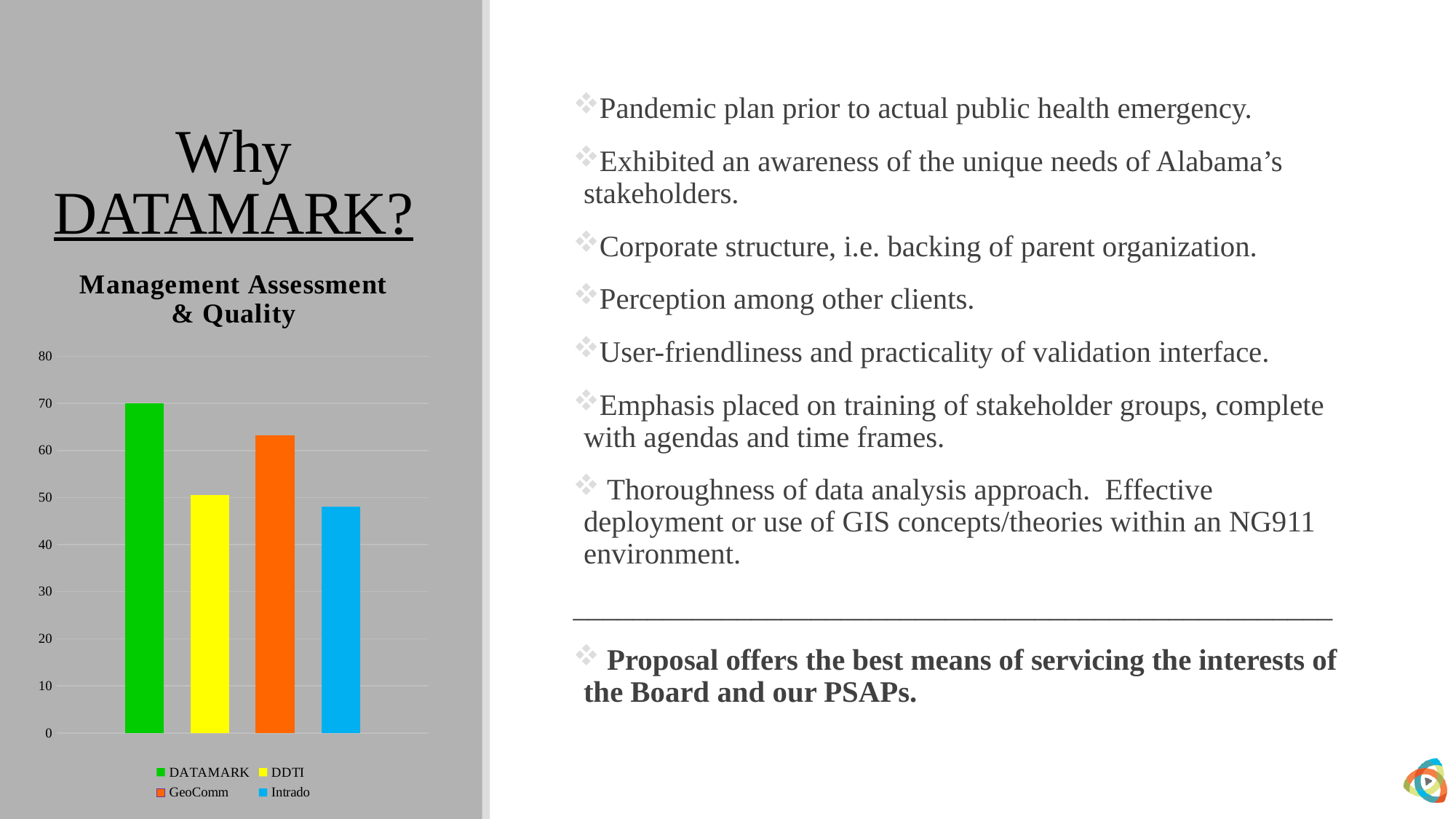
How many series does the chart legend list? 4 How many bars are plotted in the chart? 4 Is the value for Intrado greater or less than 60? less Which vendor has the lowest bar in the Management Assessment & Quality chart? Intrado What is the title of the chart on the slide? Management Assessment & Quality Is the value for DATAMARK greater or less than 60? greater Which vendor has the highest bar in the Management Assessment & Quality chart? DATAMARK What colour is the DATAMARK bar in the chart? Green Is the value for GeoComm greater or less than 70? less Which is larger in the chart, the value for DATAMARK or the value for GeoComm? DATAMARK Which is larger in the chart, the value for GeoComm or the value for DDTI? GeoComm What type of chart is shown on the slide? Bar chart